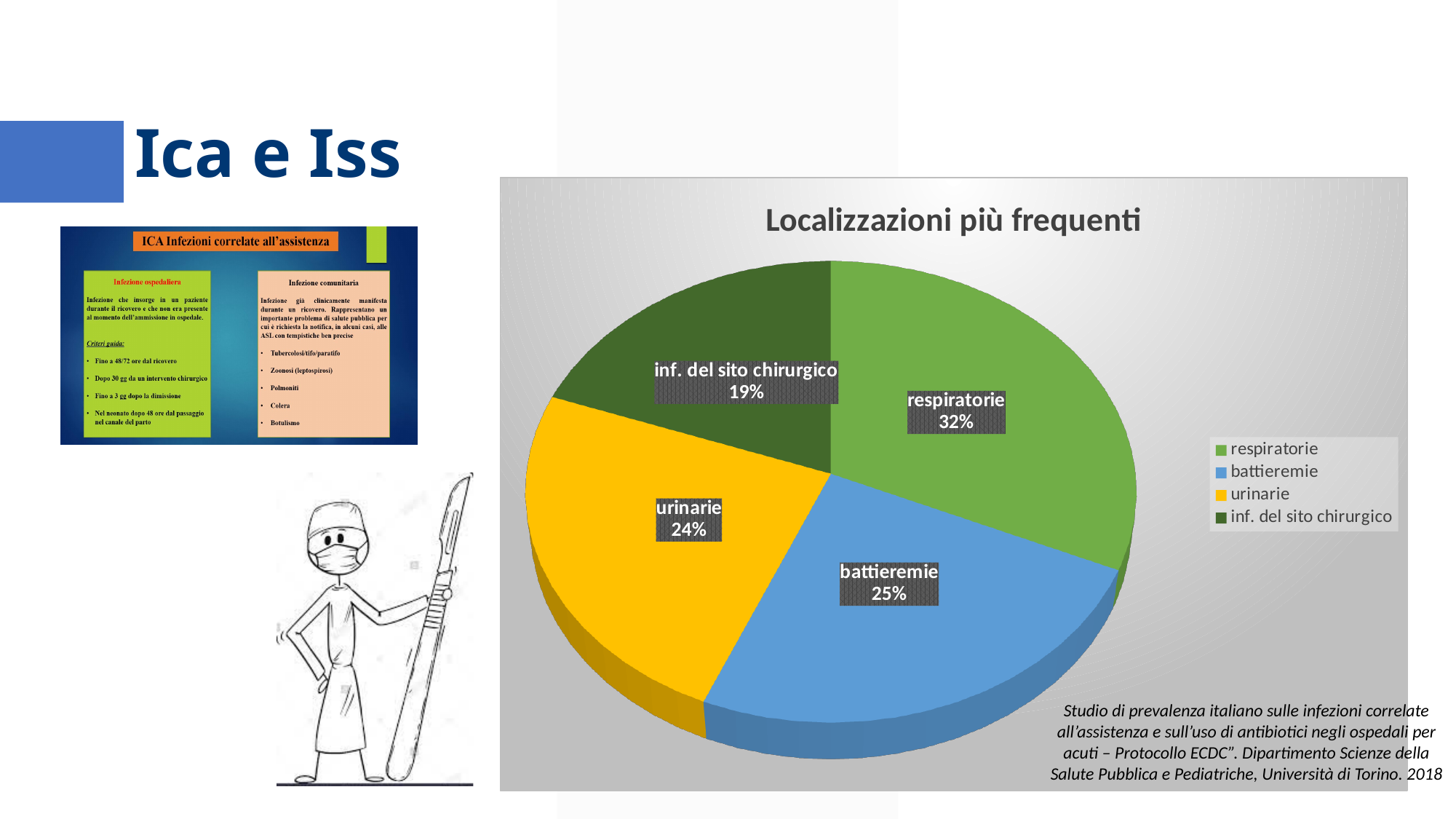
How many slices does the pie chart have? 4 What is the title of the pie chart? Localizzazioni più frequenti Which category has the smallest share of the pie? inf. del sito chirurgico What colour is the 'urinarie' slice in the pie chart? yellow What type of chart is shown under the title 'Localizzazioni più frequenti'? pie chart What percentage of the pie is 'inf. del sito chirurgico'? 19% What percentage of the pie is 'urinarie'? 24% Which category has the largest share of the pie? respiratorie Which is larger, the share for 'respiratorie' or the share for 'urinarie'? respiratorie What is the difference in percentage points between 'respiratorie' and 'inf. del sito chirurgico'? 13 What percentage of the pie is 'battieremie'? 25% What percentage of the pie is 'respiratorie'? 32%